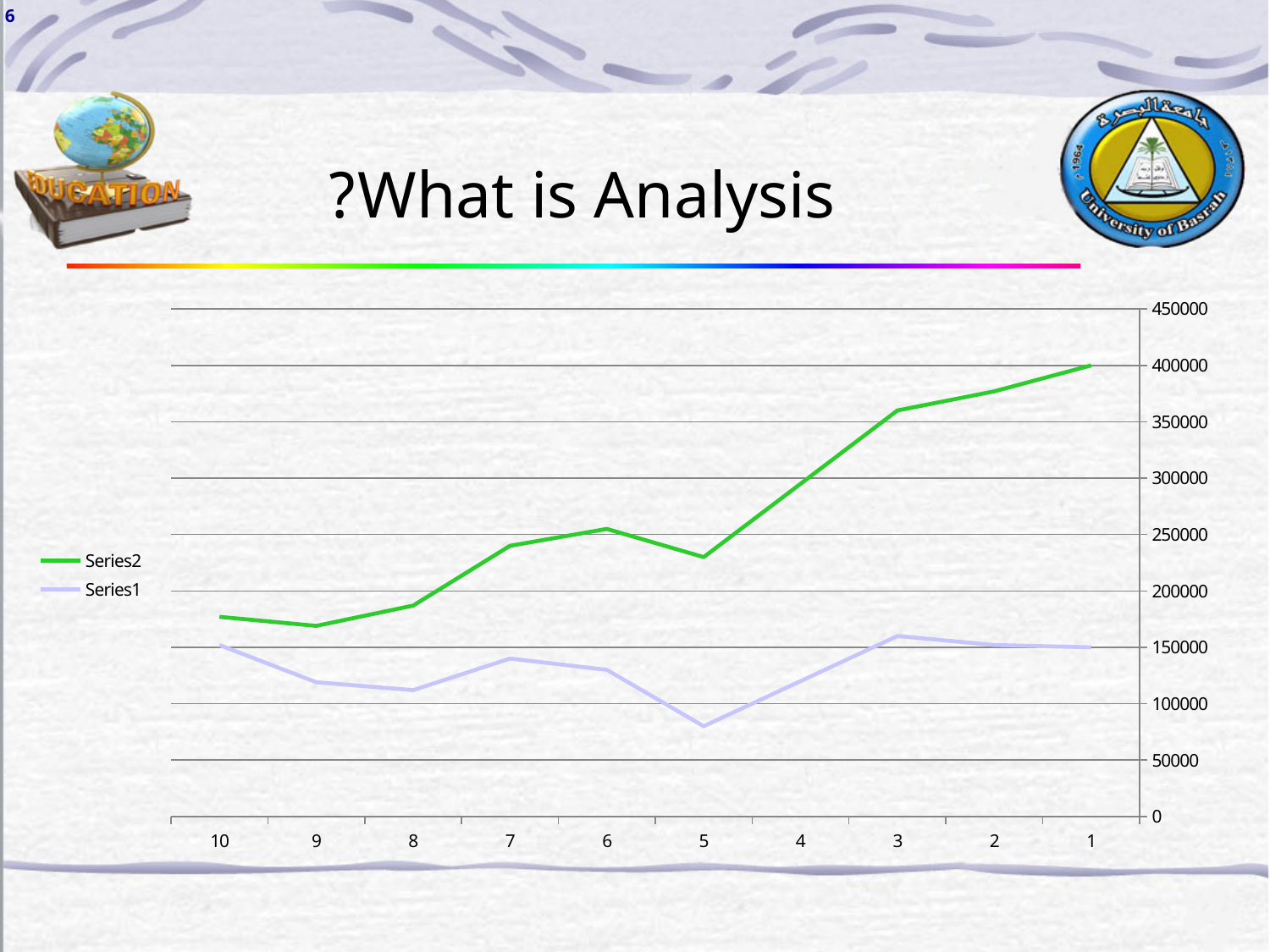
Is the value of Series2 at category 10 greater or less than 200000? less Is the value of Series2 at category 4 greater or less than 250000? greater How many series does the legend list? 2 At category 6, which series has the higher value, Series1 or Series2? Series2 At which x-axis category does Series2 reach its highest value? 1 What colour is the line for Series2? green What kind of chart is shown on the slide? line chart At which x-axis category does Series2 have its lowest value? 9 Is the value of Series1 at category 5 greater or less than 100000? less At which x-axis category does Series1 reach its highest value? 3 At which x-axis category does Series1 have its lowest value? 5 How many categories are shown on the x axis? 10